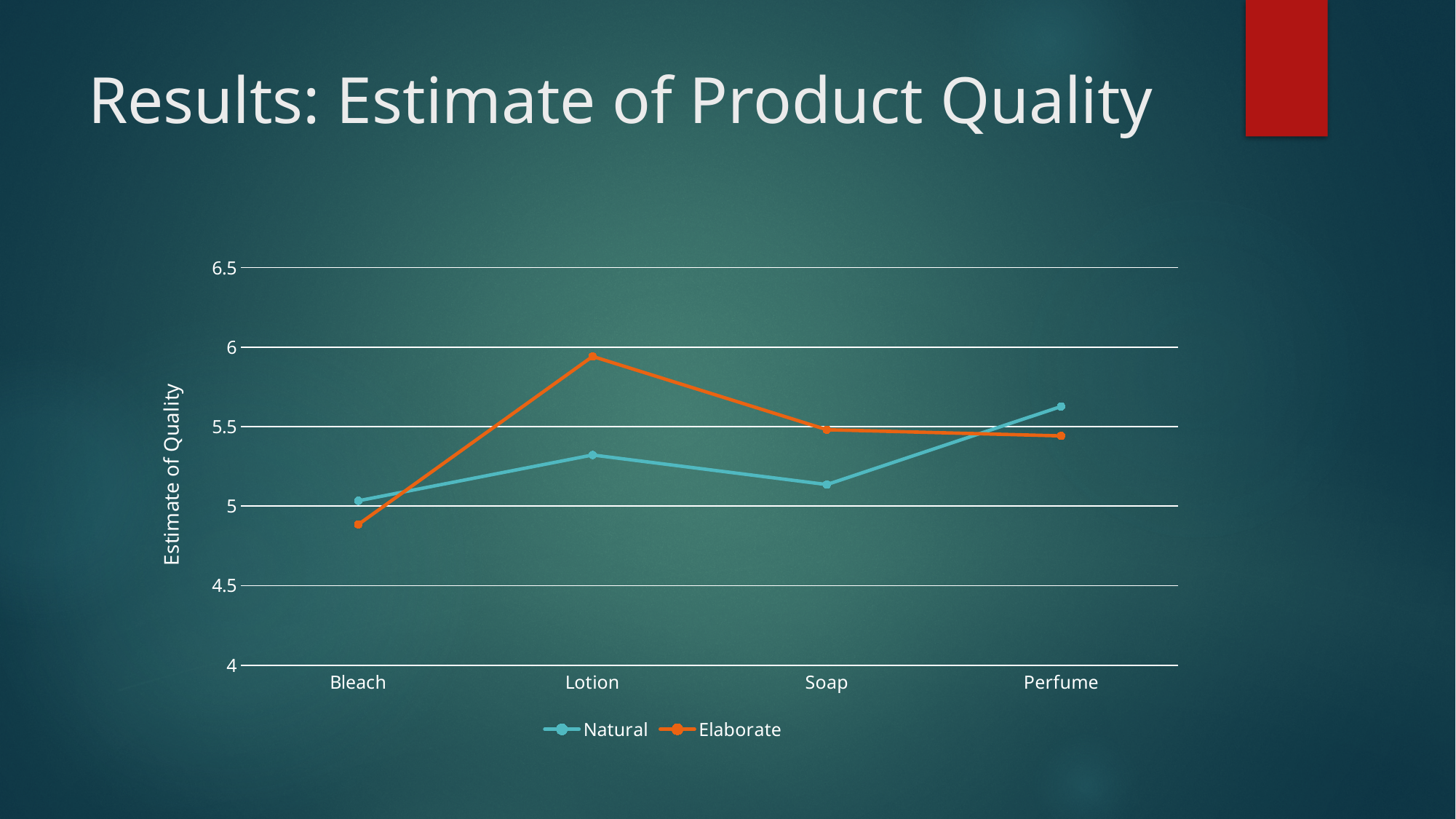
For which product is the Elaborate series lowest? Bleach For which product is the Elaborate series highest? Lotion For which product is the Natural series highest? Perfume Is the Elaborate value for Lotion greater or less than 5.5? greater Which series has the larger value for Lotion, Natural or Elaborate? Elaborate What kind of chart is shown on the slide? line chart Which series has the larger value for Perfume, Natural or Elaborate? Natural Is the Natural value for Perfume greater or less than 5.5? greater How many product categories are plotted on the x axis? 4 How many series does the legend list? 2 What is the label on the vertical axis? Estimate of Quality Is the Elaborate value for Bleach greater or less than 5? less